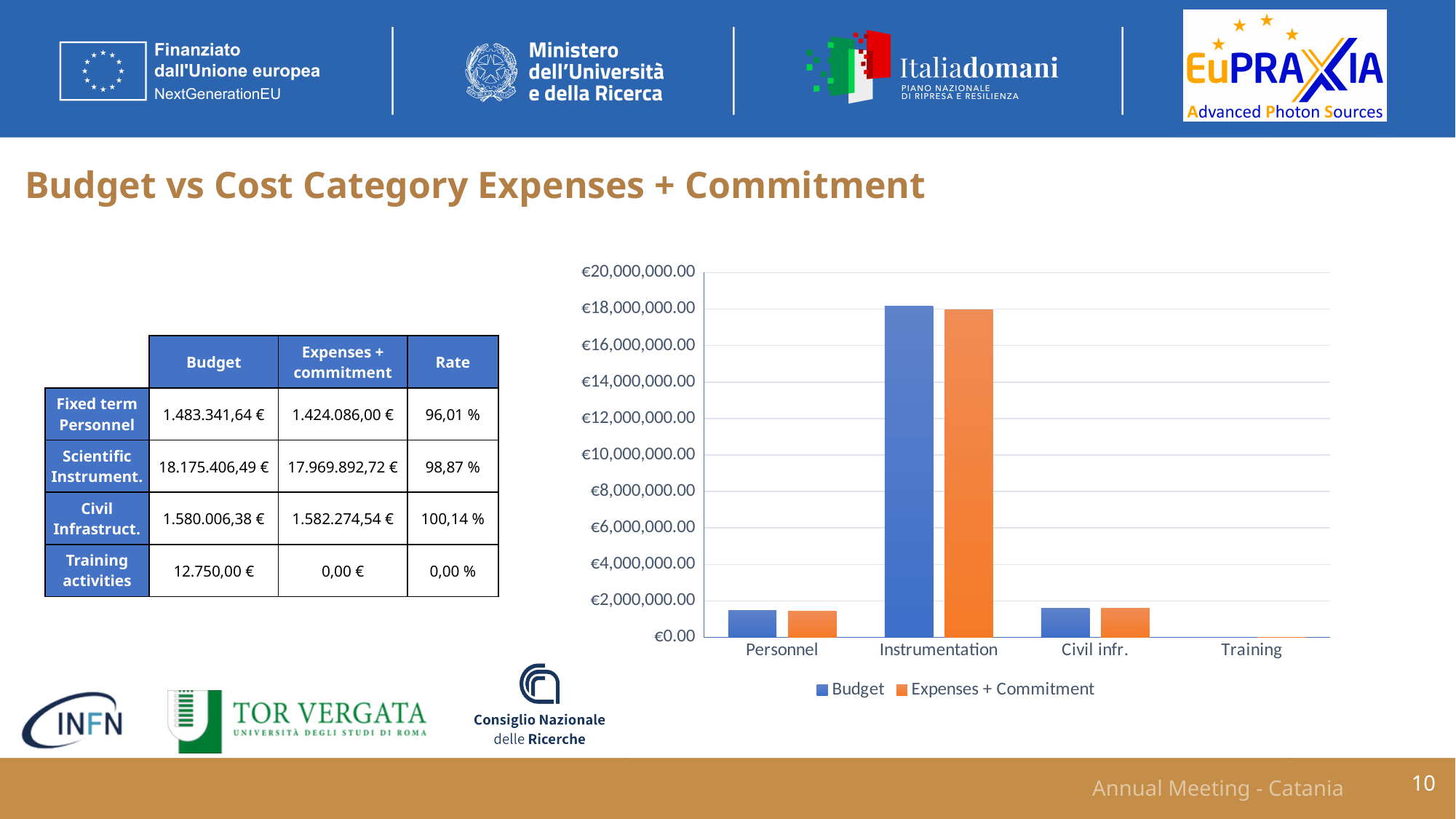
How many series does the chart legend list? 2 Which colour represents the Budget series in the chart? blue Is the Expenses + Commitment value for Civil infr. greater or less than €2,000,000.00? less How many categories are shown on the x axis of the chart? 4 What is the title of the slide containing the chart? Budget vs Cost Category Expenses + Commitment Is the Budget value for Personnel greater or less than €2,000,000.00? less Which category has the lowest Budget bar in the chart? Training Is the Budget value for Instrumentation greater or less than €16,000,000.00? greater What kind of chart is shown on the slide? bar chart Which is larger for Civil infr.: the Budget bar or the Personnel Budget bar? Civil infr. Which category has the highest Budget bar in the chart? Instrumentation